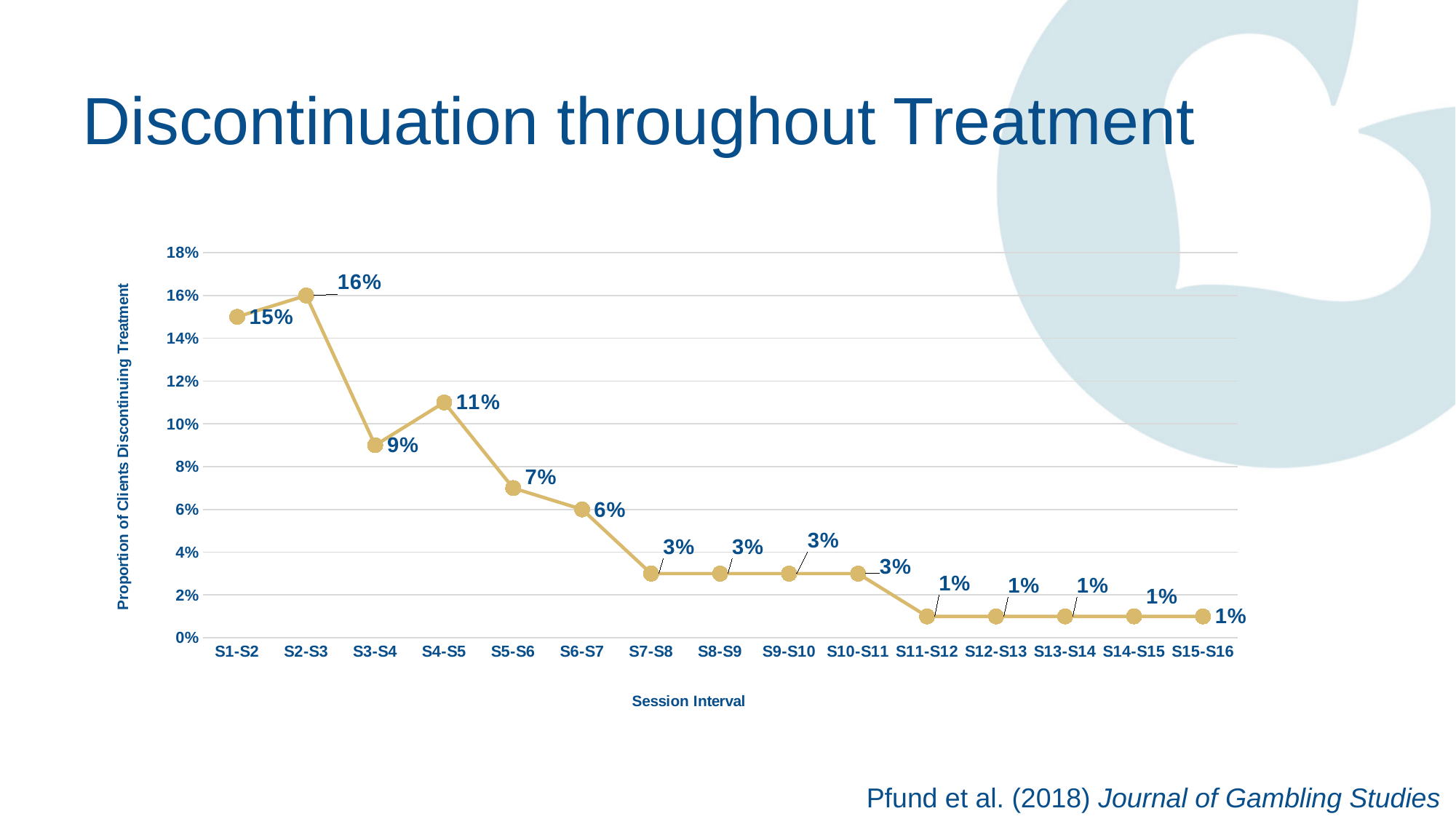
Do the values generally rise or fall from S2-S3 to S15-S16? fall What is the value for the S4-S5 session interval? 11% Which is larger, the value for S3-S4 or the value for S4-S5? S4-S5 Is the value for S5-S6 greater or less than 10%? less What is the difference between the values for S2-S3 and S3-S4? 7% Which session interval has the highest proportion of clients discontinuing treatment? S2-S3 What is the proportion of clients discontinuing treatment at the S2-S3 session interval? 16% How many session intervals are plotted on the x axis? 15 What kind of chart is shown on the slide? line chart What is the difference between the values for S1-S2 and S15-S16? 14% What is the label of the y axis? Proportion of Clients Discontinuing Treatment What is the value for the S6-S7 session interval? 6%